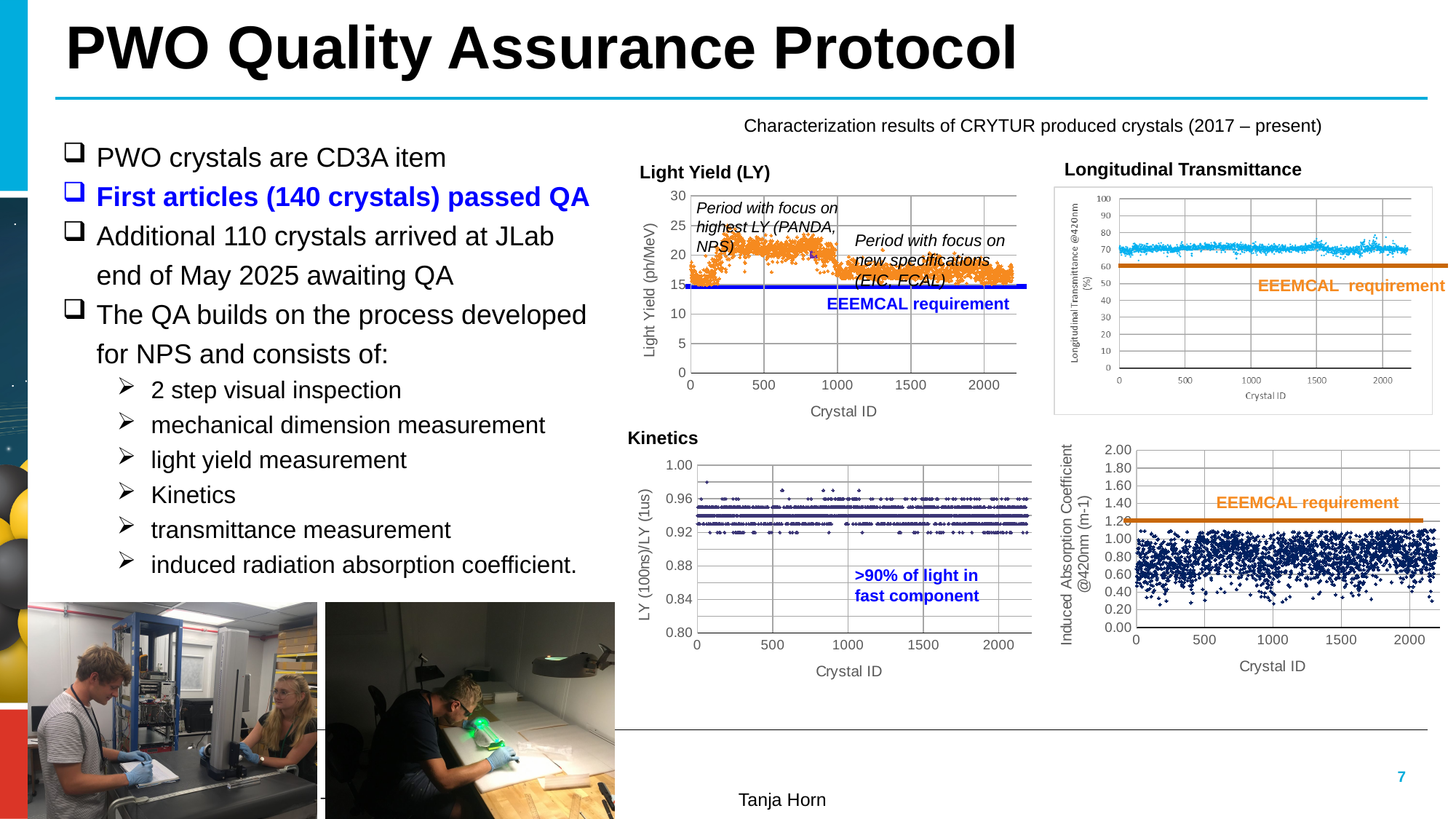
What does the horizontal orange line in the Longitudinal Transmittance chart represent? EEEMCAL requirement In the Longitudinal Transmittance chart, are the transmittance values greater or less than 80%? less What is the x-axis label of the Kinetics chart? Crystal ID What kind of chart is the Light Yield (LY) chart? scatter chart In the Light Yield (LY) chart, is the light yield for crystals around Crystal ID 500 greater or less than 15 ph/MeV? greater In the Light Yield (LY) chart, do the light yield values rise or fall going from Crystal ID 500 to Crystal ID 1500? fall In the Kinetics chart, are the LY (100ns)/LY (1us) values greater or less than 0.88? greater What kind of chart is the Longitudinal Transmittance chart? scatter chart